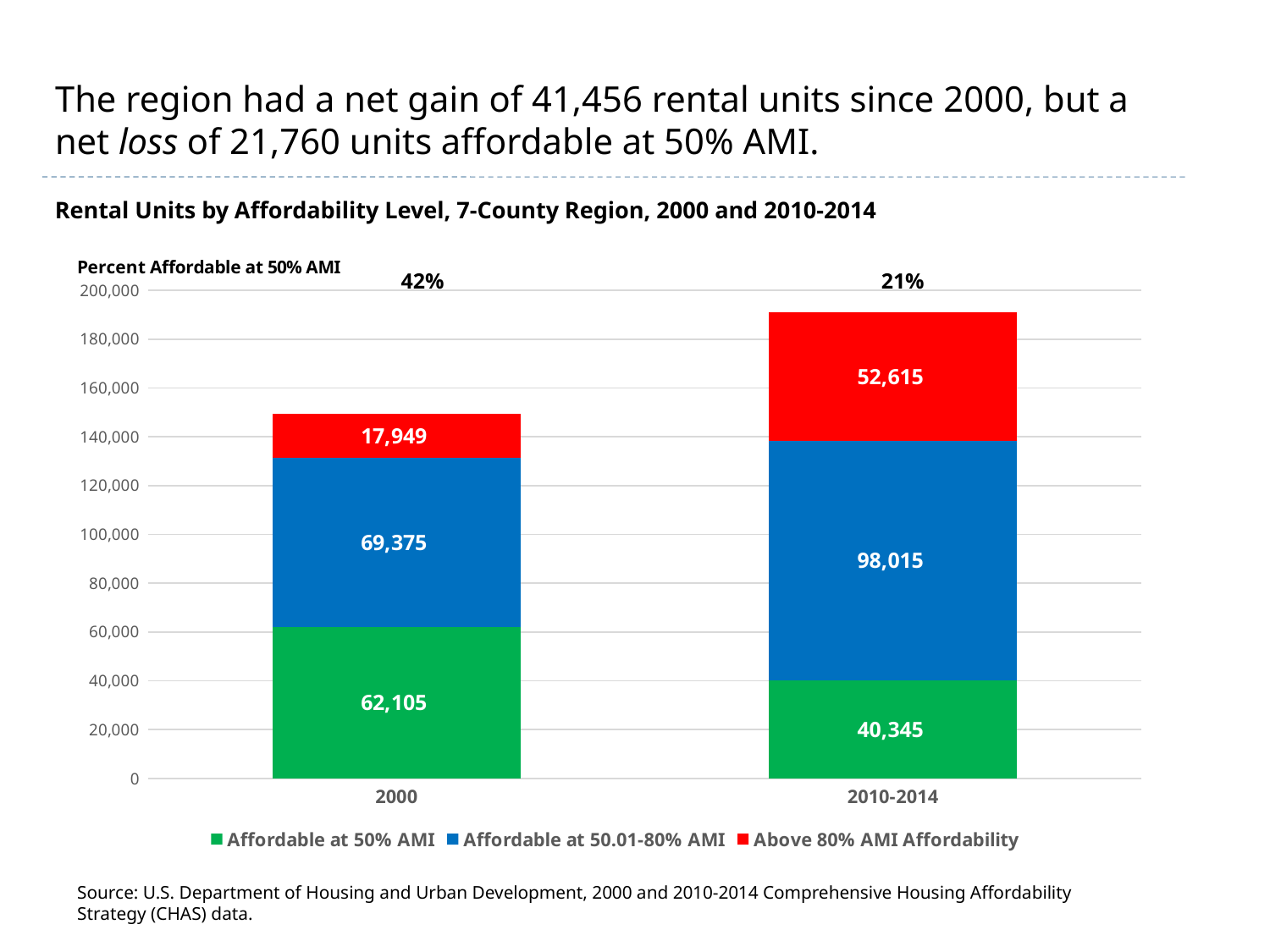
How many categories are shown on the x axis? 2 What is the total of the stacked bar for 2000? 149,429 What type of chart is shown on the slide? Stacked bar chart What is the total of the stacked bar for 2010-2014? 190,975 Which period has the larger value for Above 80% AMI Affordability, 2000 or 2010-2014? 2010-2014 What is the value for Above 80% AMI Affordability in 2010-2014? 52,615 What is the value for Affordable at 50.01-80% AMI in 2010-2014? 98,015 What percent of rental units were affordable at 50% AMI in 2010-2014? 21% How many series does the legend list? 3 What is the value for Affordable at 50% AMI in 2000? 62,105 What is the title of the chart? Rental Units by Affordability Level, 7-County Region, 2000 and 2010-2014 By how much did the number of units Affordable at 50% AMI decrease from 2000 to 2010-2014? 21,760